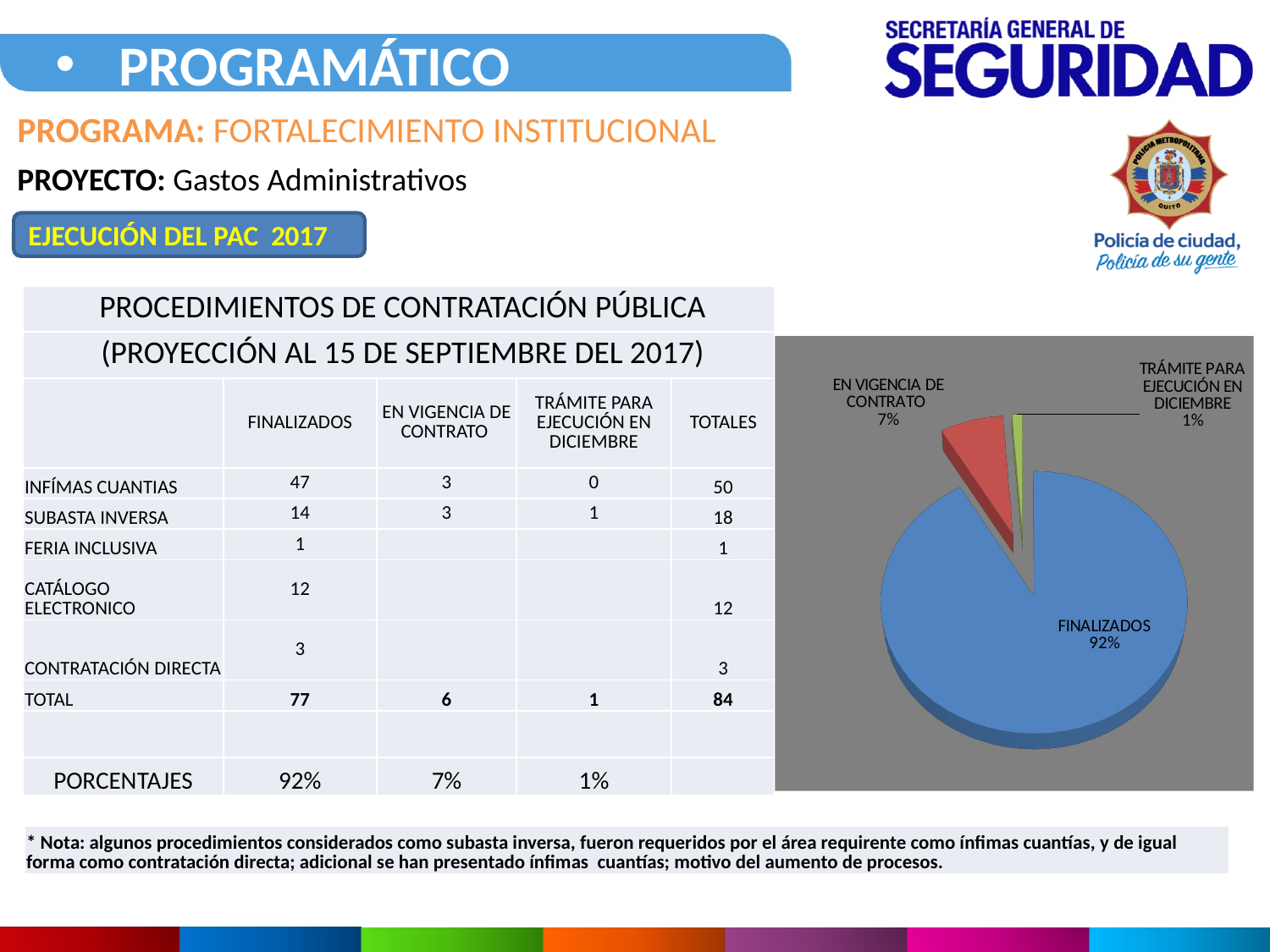
What colour is the FINALIZADOS slice in the pie chart? blue Which is larger in the pie chart, EN VIGENCIA DE CONTRATO or TRÁMITE PARA EJECUCIÓN EN DICIEMBRE? EN VIGENCIA DE CONTRATO How many slices does the pie chart have? 3 Which slice of the pie chart is the smallest? TRÁMITE PARA EJECUCIÓN EN DICIEMBRE Which slice of the pie chart is the largest? FINALIZADOS What kind of chart is shown on the slide? pie chart What is the difference in percentage points between the EN VIGENCIA DE CONTRATO slice and the TRÁMITE PARA EJECUCIÓN EN DICIEMBRE slice? 6 What is the difference in percentage points between the FINALIZADOS slice and the EN VIGENCIA DE CONTRATO slice? 85 What colour is the EN VIGENCIA DE CONTRATO slice in the pie chart? red What share of the pie does TRÁMITE PARA EJECUCIÓN EN DICIEMBRE represent? 1% What share of the pie does FINALIZADOS represent? 92% What share of the pie does EN VIGENCIA DE CONTRATO represent? 7%